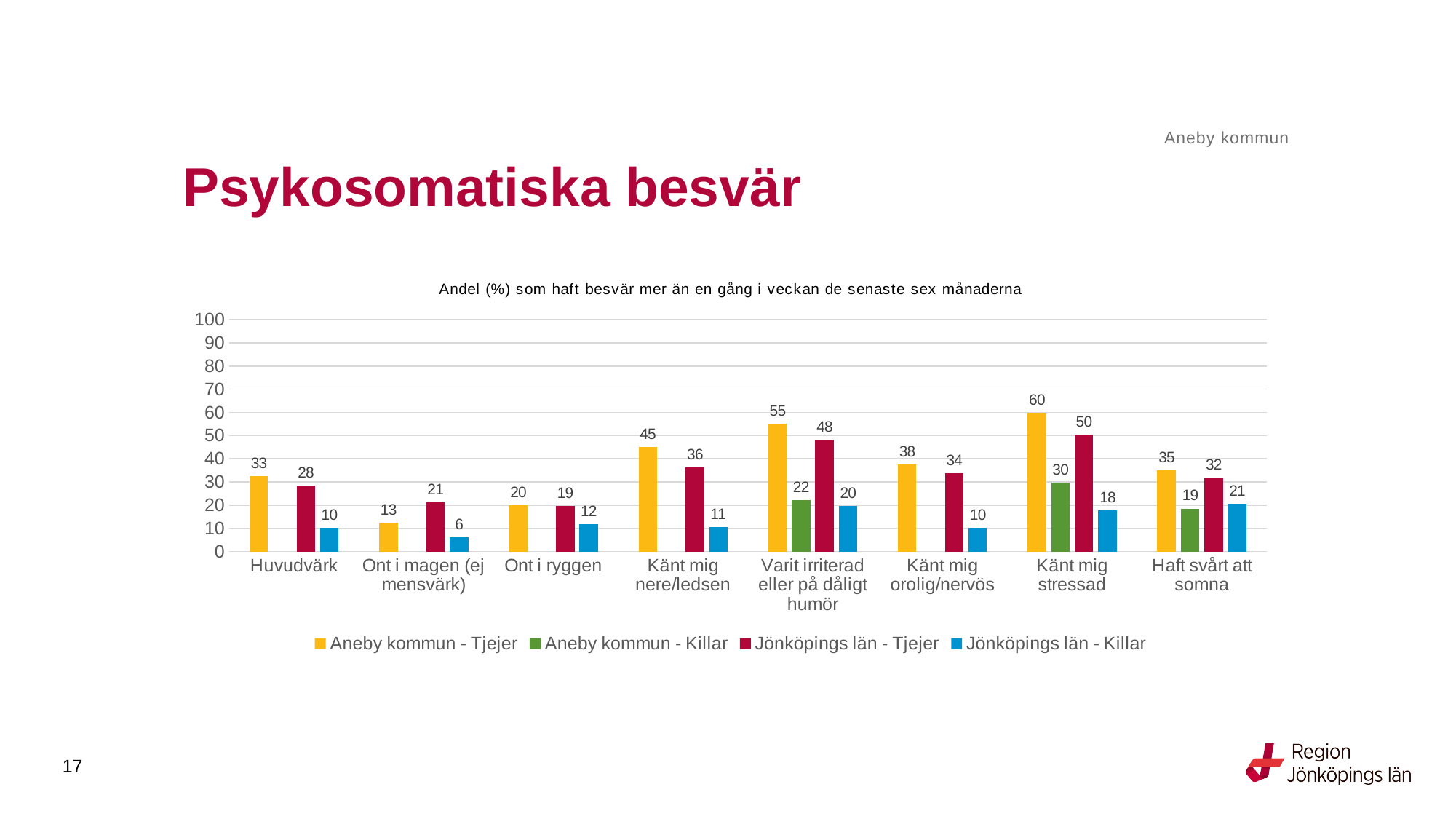
Which category has the lowest value for Aneby kommun - Tjejer? Ont i magen (ej mensvärk) How many series does the legend list? 4 Which category has the highest value for Jönköpings län - Tjejer? Känt mig stressad What kind of chart is shown on the slide? Bar chart How many categories are shown on the x axis? 8 What is the value for Aneby kommun - Tjejer for Känt mig stressad? 60 What is the value for Aneby kommun - Killar for Varit irriterad eller på dåligt humör? 22 What is the difference between Aneby kommun - Tjejer and Jönköpings län - Tjejer for Känt mig nere/ledsen? 9 What is the value for Jönköpings län - Killar for Ont i magen (ej mensvärk)? 6 Which is larger for Haft svårt att somna: Aneby kommun - Killar or Jönköpings län - Killar? Jönköpings län - Killar Is the value for Aneby kommun - Tjejer for Varit irriterad eller på dåligt humör greater or less than 50? greater What is the subtitle printed above the chart? Andel (%) som haft besvär mer än en gång i veckan de senaste sex månaderna